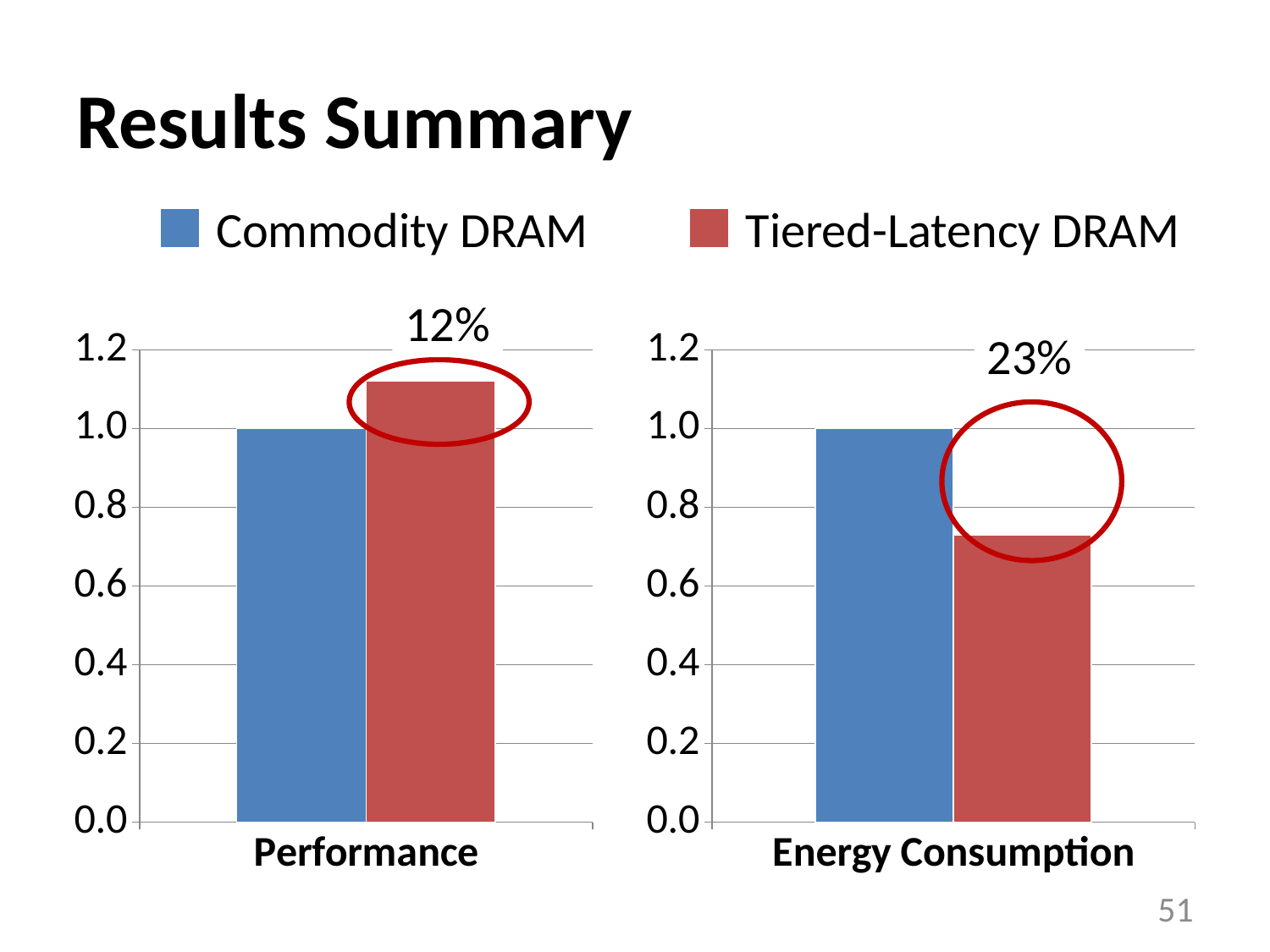
What percentage annotation is shown above the Tiered-Latency DRAM bar in the Performance chart? 12% In the Energy Consumption chart, which series has the lower bar? Tiered-Latency DRAM In the Performance chart, what is the value for Commodity DRAM? 1.0 How many bars are in the Energy Consumption chart? 2 In the Performance chart, is the value for Tiered-Latency DRAM greater or less than 1.0? greater In the Energy Consumption chart, is the Commodity DRAM bar larger or smaller than the Tiered-Latency DRAM bar? larger What kind of chart is the Performance chart? bar chart In the Performance chart, which series has the higher bar? Tiered-Latency DRAM In the Energy Consumption chart, is the value for Tiered-Latency DRAM greater or less than 0.8? less How many series does the legend list? 2 What percentage annotation is shown in the Energy Consumption chart? 23% In the Energy Consumption chart, what is the value for Commodity DRAM? 1.0